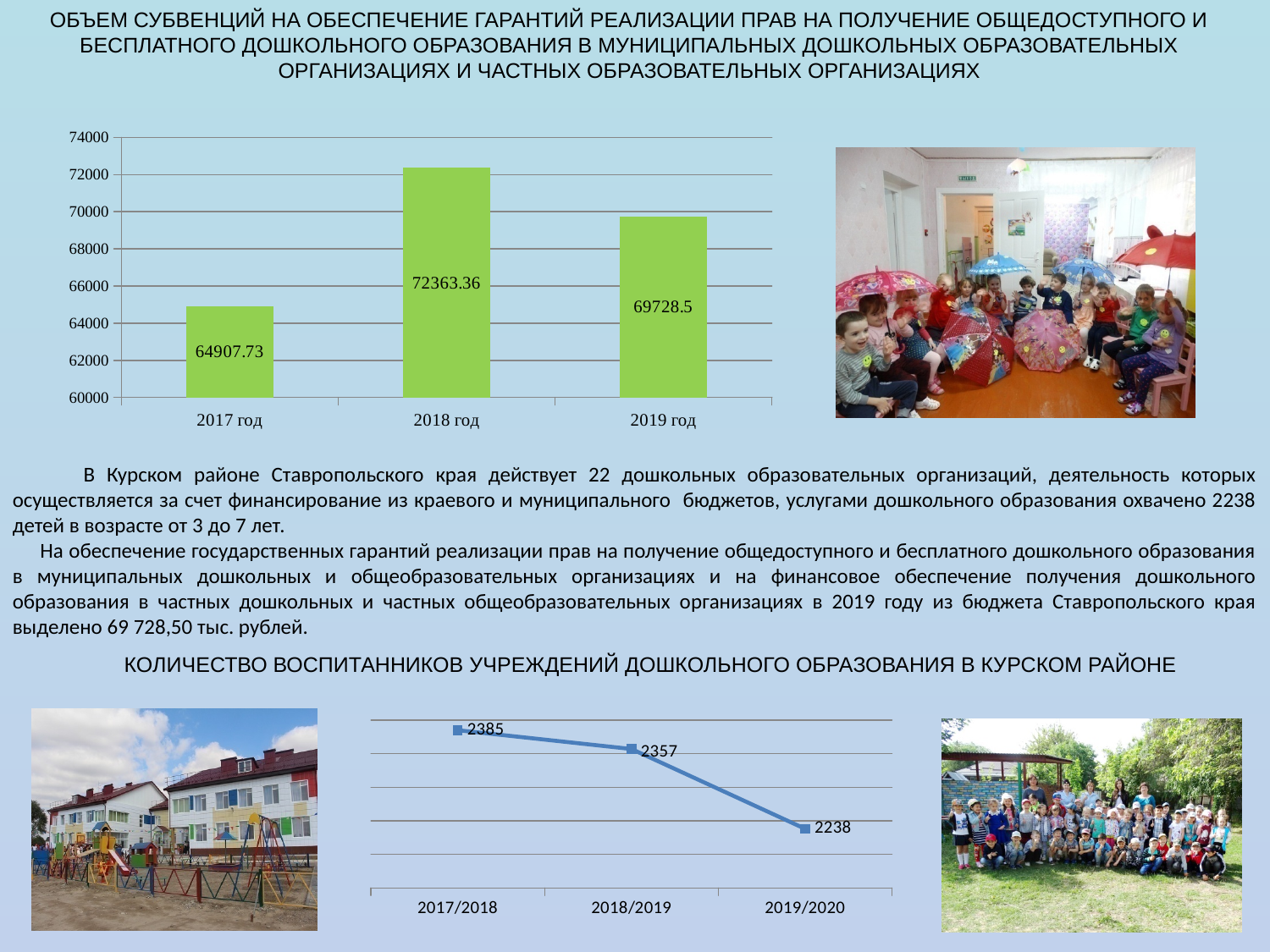
In the top bar chart on subvention volume, which year has the highest value? 2018 год In the top bar chart on subvention volume, what is the value for 2017 год? 64907.73 In the bottom line chart on the number of pupils, do the values rise or fall from 2017/2018 to 2019/2020? fall In the bottom line chart on the number of pupils, what is the value for 2019/2020? 2238 In the top bar chart on subvention volume, what is the difference between the 2018 год and 2019 год values? 2634.86 In the bottom line chart on the number of pupils, what is the difference between the 2017/2018 and 2019/2020 values? 147 How many data points are plotted in the bottom line chart on the number of pupils? 3 In the bottom line chart on the number of pupils, what is the value for 2018/2019? 2357 In the top bar chart on subvention volume, what is the value for 2018 год? 72363.36 What type of chart is the top chart on subvention volume? bar chart In the top bar chart on subvention volume, is the value for 2019 год greater or less than 70000? less In the top bar chart on subvention volume, which year has the lowest value? 2017 год